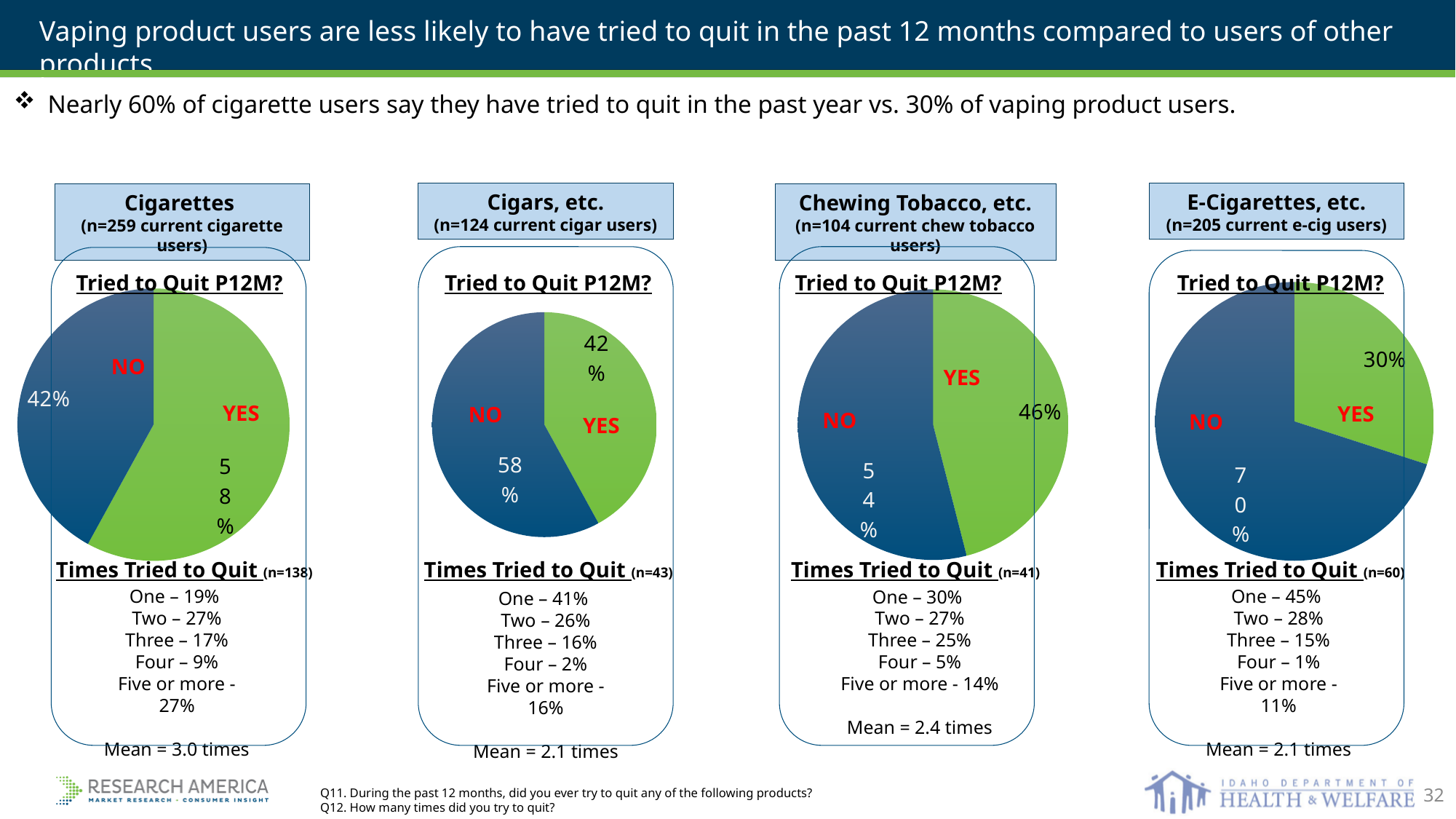
In the Chewing Tobacco, etc. pie chart, what percentage said NO? 54% In the Cigarettes pie chart, what percentage of current cigarette users said YES to having tried to quit in the past 12 months? 58% In the E-Cigarettes, etc. pie chart, what percentage said NO? 70% In the E-Cigarettes, etc. pie chart, what percentage said YES to having tried to quit in the past 12 months? 30% In the Cigars, etc. pie chart, what percentage said YES to having tried to quit in the past 12 months? 42% In the Cigars, etc. pie chart, what colour is the NO slice? Blue What type of chart is used to show whether users tried to quit in the past 12 months? Pie chart In the E-Cigarettes, etc. pie chart, which slice is larger, YES or NO? NO In the Cigarettes pie chart, which slice is larger, YES or NO? YES In the Chewing Tobacco, etc. pie chart, what is the difference between the NO and YES percentages? 8% How many pie charts are shown on the slide? 4 In the Cigarettes pie chart, what percentage said NO? 42%